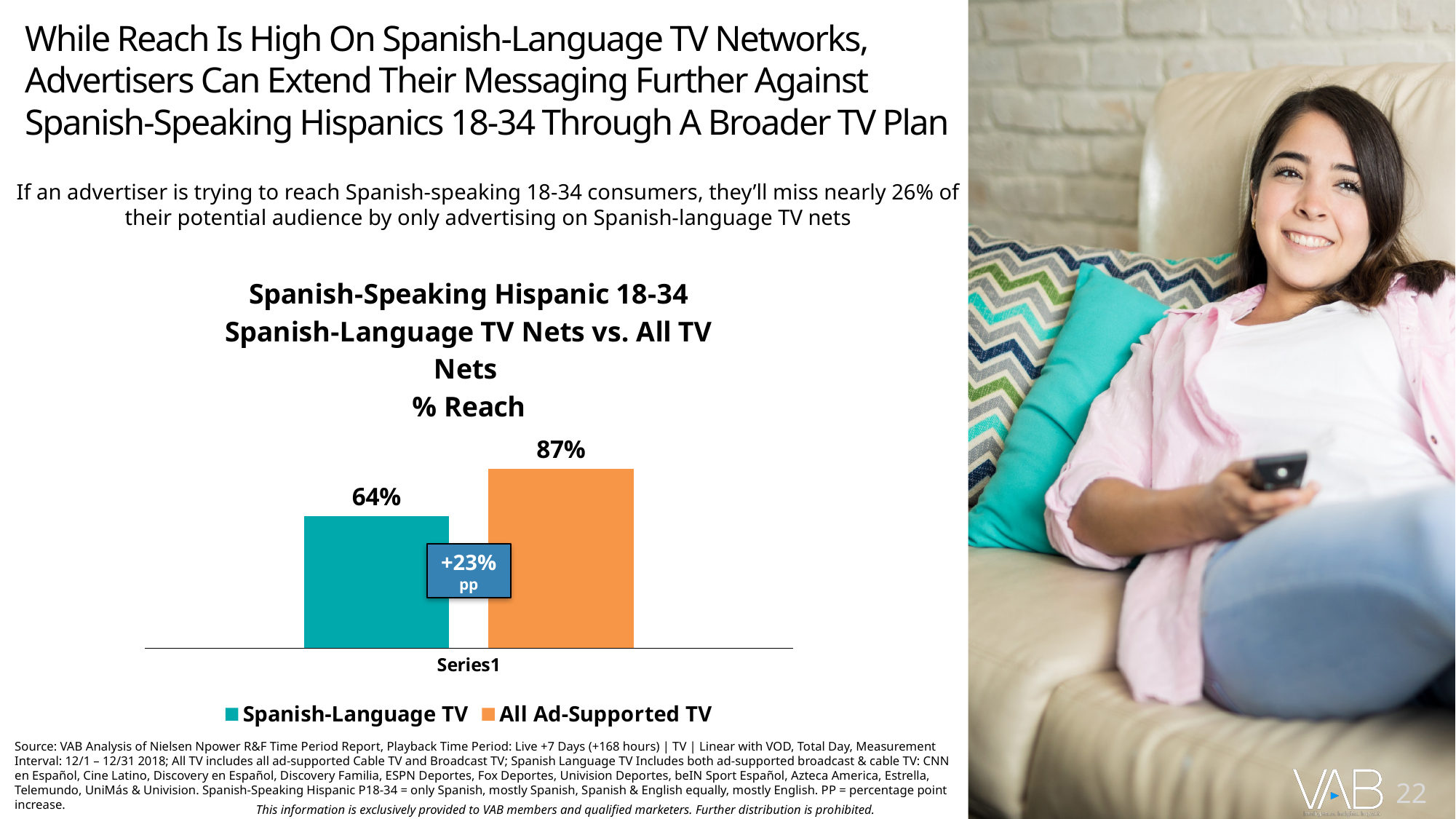
How many series does the legend list? 2 What is the difference in % reach between All Ad-Supported TV and Spanish-Language TV? 23% What is the % reach for All Ad-Supported TV? 87% Which series has the lower % reach? Spanish-Language TV Which series has the higher % reach? All Ad-Supported TV Is the % reach for Spanish-Language TV larger or smaller than that for All Ad-Supported TV? smaller What kind of chart is shown on the slide? bar chart What is the category label shown on the x axis? Series1 What is the % reach for Spanish-Language TV? 64% What percentage point increase is shown in the callout box between the two bars? +23% pp What colour is the bar for All Ad-Supported TV? orange